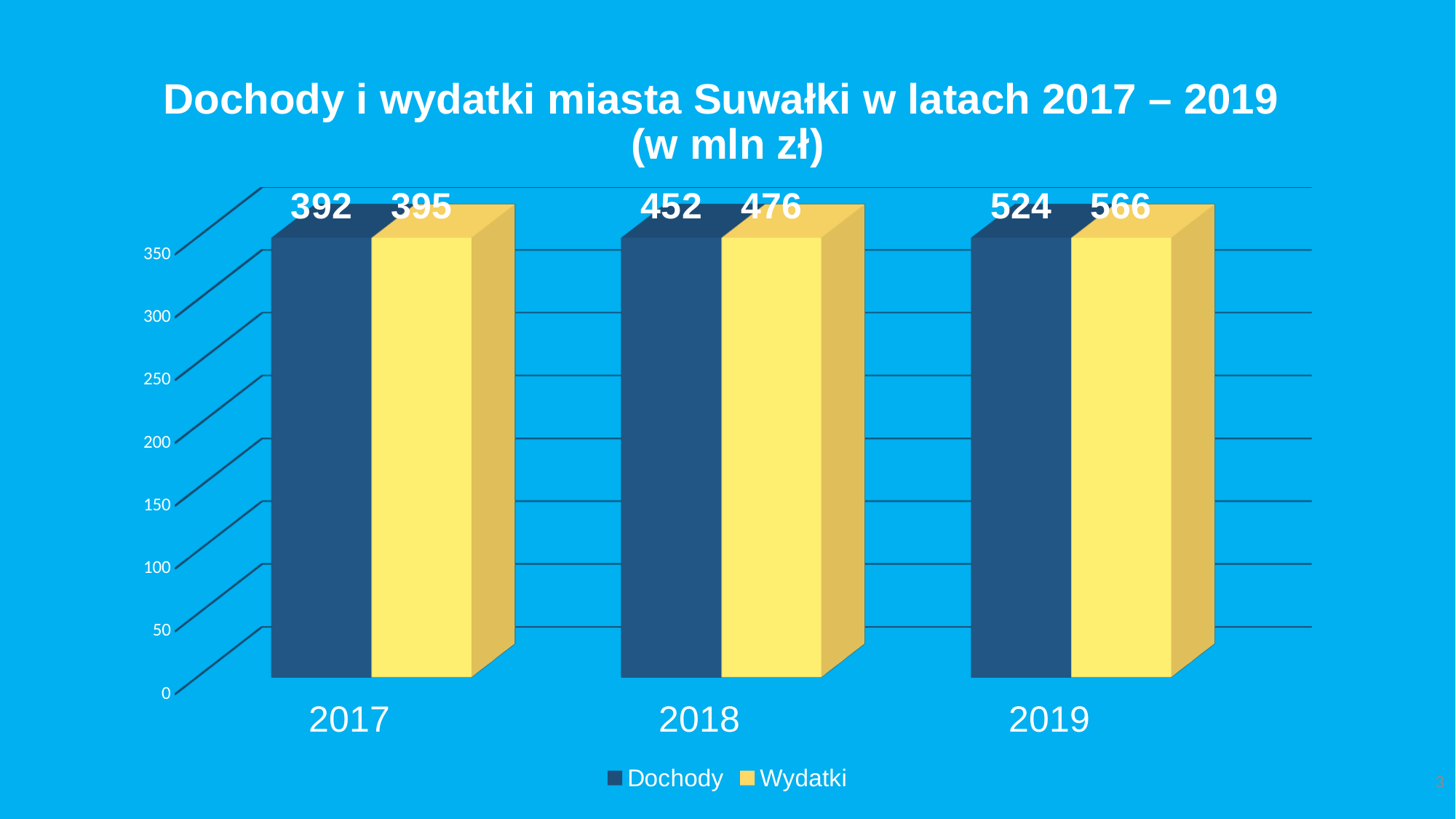
Do the Dochody values rise or fall from 2017 to 2019? Rise What is the Wydatki value for 2019? 566 What is the Wydatki value for 2018? 476 Which is larger in 2018, Dochody or Wydatki? Wydatki Which year has the highest Dochody value? 2019 What kind of chart is shown on the slide? Bar chart What is the difference between the Dochody values for 2018 and 2017? 60 How many series does the legend list? 2 What is the difference between Wydatki and Dochody in 2019? 42 What is the Dochody value for 2017? 392 How many years are shown on the x axis? 3 Which year has the lowest Wydatki value? 2017